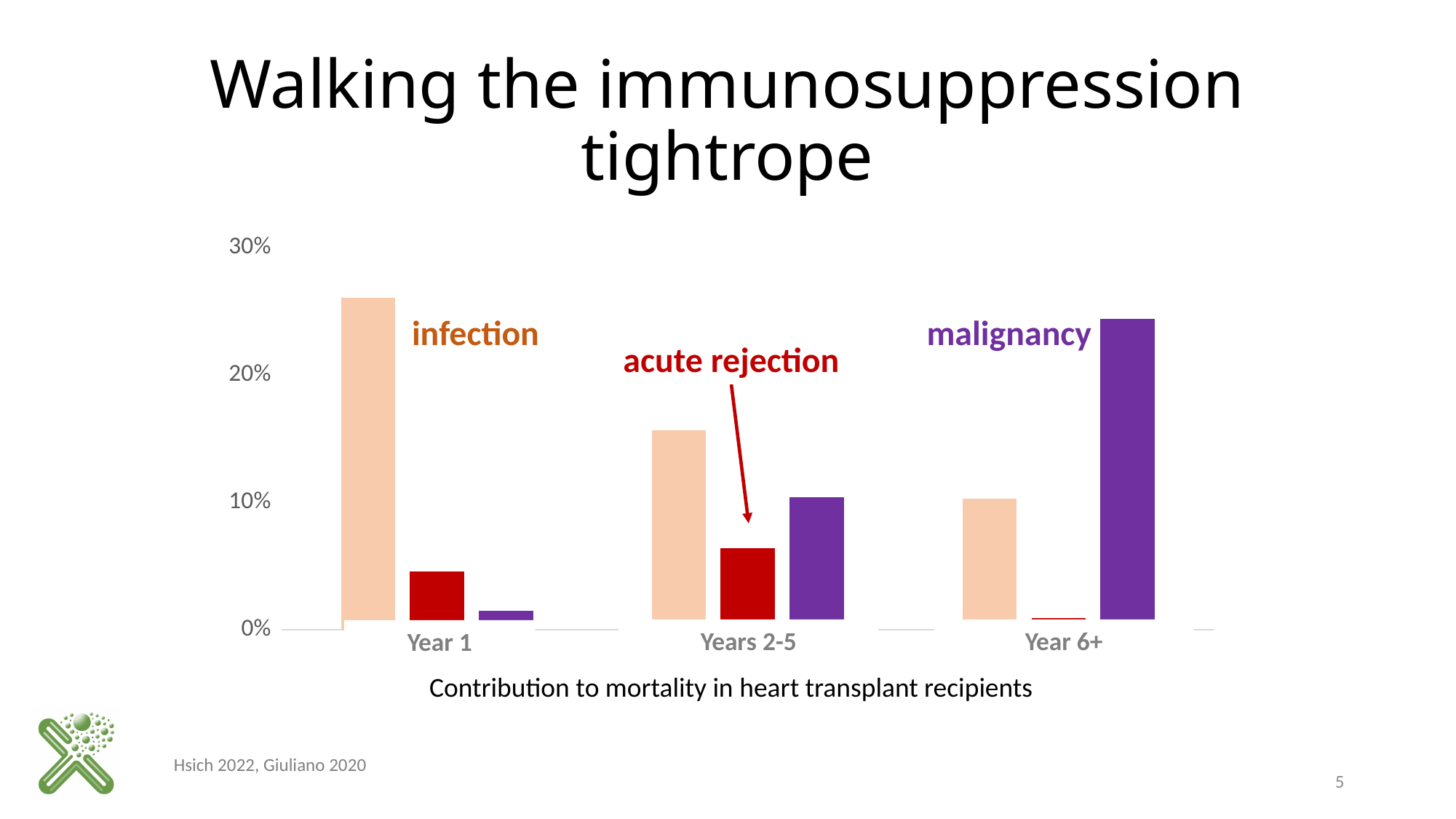
How many time-period categories are shown on the x axis? 3 What caption appears below the x axis of the chart? Contribution to mortality in heart transplant recipients Does the infection contribution rise or fall from Year 1 to Year 6+? fall In which time period is the malignancy bar lowest? Year 6+ For Years 2-5, which is larger: the malignancy bar or the acute rejection bar? malignancy Is the infection value for Year 1 greater or less than 20%? greater How many causes of mortality (series) are plotted in the chart? 3 Is the malignancy value for Year 6+ greater or less than 20%? greater In which time period is the infection bar highest? Year 1 Is the acute rejection value for Years 2-5 greater or less than 10%? less What kind of chart is shown on the slide? bar chart